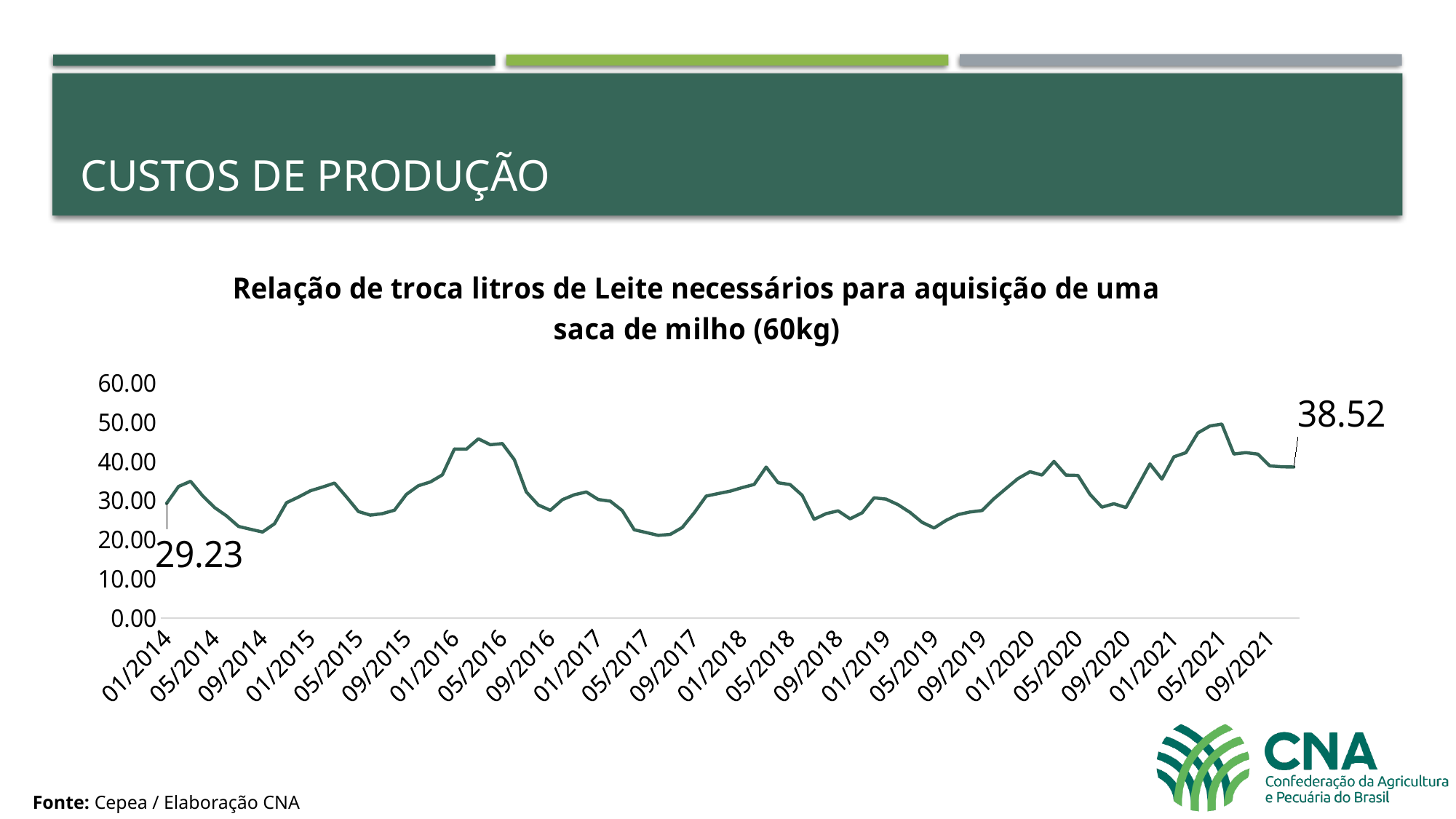
Which is larger, the first labelled value (29.23) or the last labelled value (38.52)? 38.52 What type of chart is shown on the slide? line chart Is the value for 05/2016 greater or less than 40.00? greater What is the highest value shown on the y axis? 60.00 What is the value labelled at the first point of the line (01/2014)? 29.23 Is the value for 05/2019 greater or less than 30.00? less Is the value for 09/2014 greater or less than 30.00? less What is the value labelled at the last point of the line? 38.52 What is the difference between the last labelled value (38.52) and the first labelled value (29.23)? 9.29 How many date labels are shown on the x axis? 24 What is the title of the chart? Relação de troca litros de Leite necessários para aquisição de uma saca de milho (60kg)